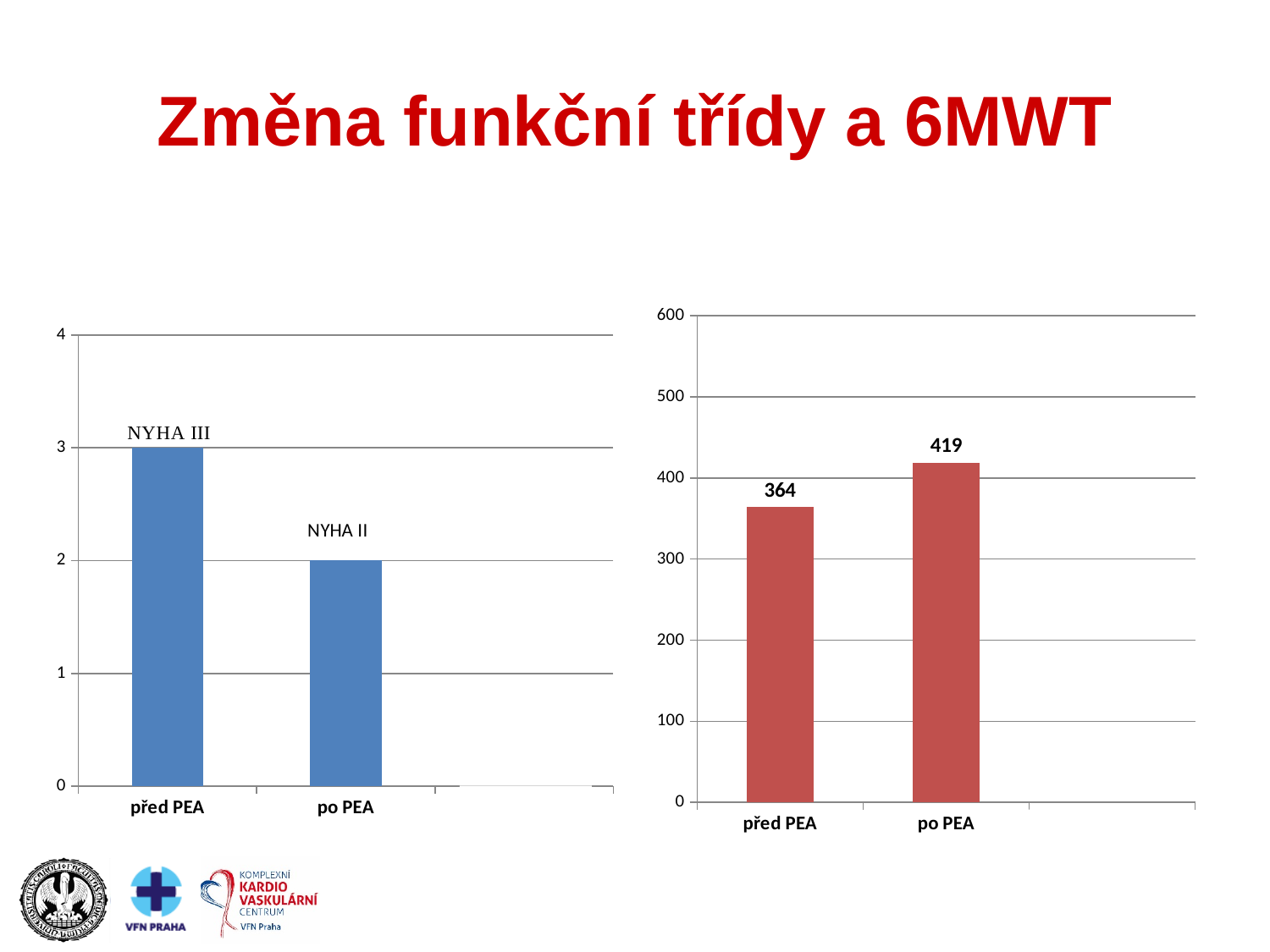
On the right-hand chart, what is the difference between the po PEA and před PEA values? 55 On the left-hand chart, what value does the před PEA bar reach? 3 On the right-hand chart, what is the value for před PEA? 364 On the left-hand chart, do the values rise or fall from před PEA to po PEA? fall On the left-hand chart, which category has the highest value? před PEA On the right-hand chart, which category has the higher value, před PEA or po PEA? po PEA On the left-hand chart, what value does the po PEA bar reach? 2 What kind of chart is the left-hand chart? bar chart On the left-hand chart, what label is written above the před PEA bar? NYHA III On the right-hand chart, is the value for po PEA greater or less than 400? greater On the right-hand chart, what is the value for po PEA? 419 On the right-hand chart, which category has the lowest value? před PEA